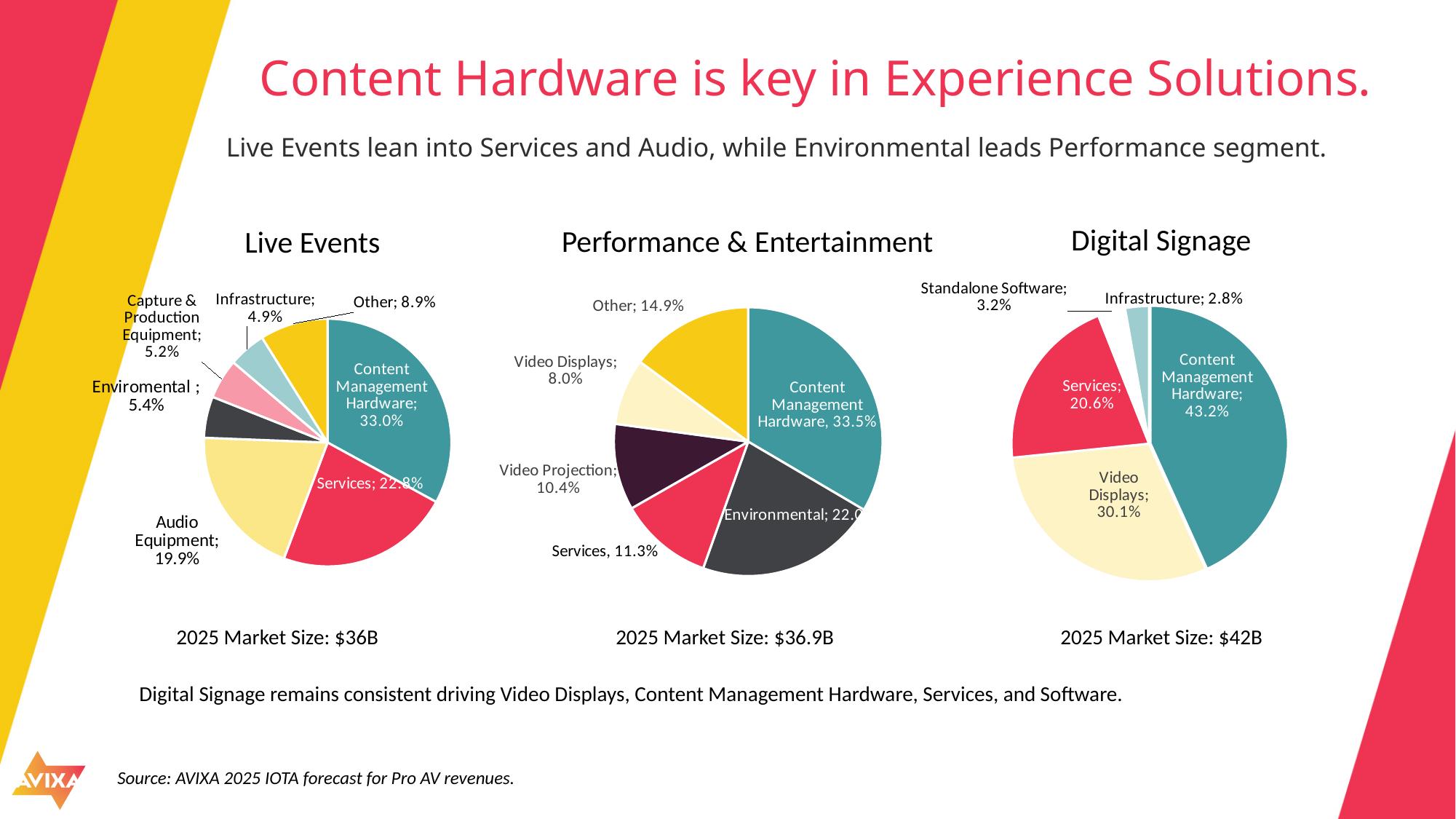
In the Performance & Entertainment pie chart, which category has the smallest share? Video Displays In the Performance & Entertainment pie chart, what is the share for Video Projection? 10.4% In the Performance & Entertainment pie chart, how many categories are shown? 6 What type of chart is used for Digital Signage? Pie chart In the Live Events pie chart, which category has the smallest share? Infrastructure In the Digital Signage pie chart, which is larger, Services or Standalone Software? Services In the Performance & Entertainment pie chart, what is the difference between the Other share and the Services share? 3.6% In the Live Events pie chart, which category has the largest share? Content Management Hardware In the Live Events pie chart, what is the share for Audio Equipment? 19.9% In the Live Events pie chart, what share does Content Management Hardware hold? 33.0% In the Digital Signage pie chart, what is the share for Video Displays? 30.1% In the Digital Signage pie chart, how many categories are shown? 5